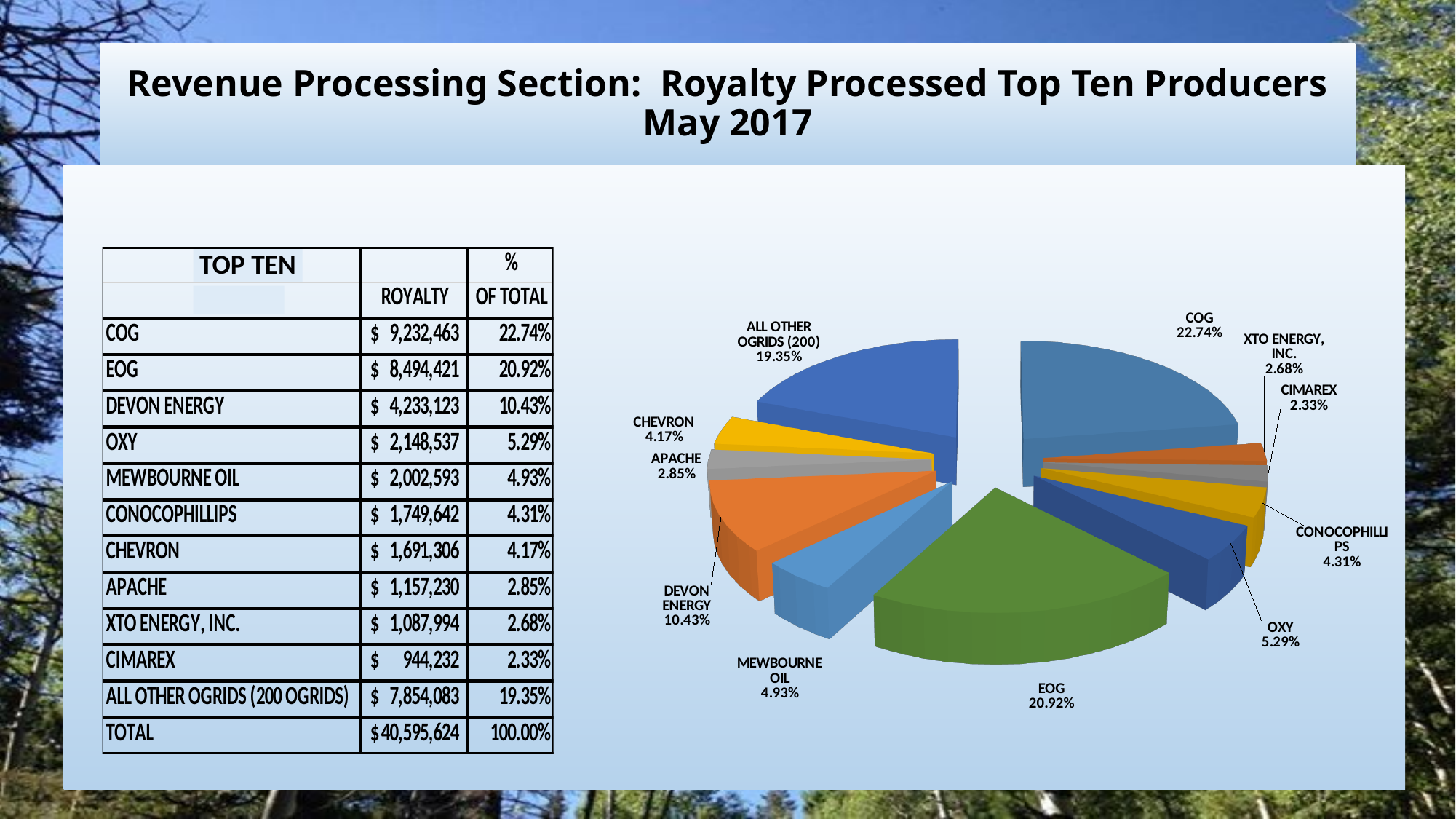
Which slice of the pie chart is the smallest? CIMAREX What colour is the EOG slice in the pie chart? green What share of the pie chart does COG account for? 22.74% What percentage is shown for ALL OTHER OGRIDS (200) in the pie chart? 19.35% What kind of chart is shown on the slide? pie chart Which slice is larger in the pie chart, DEVON ENERGY or ALL OTHER OGRIDS (200)? ALL OTHER OGRIDS (200) What share of the pie chart does EOG account for? 20.92% What is the difference in percentage points between the COG slice and the EOG slice? 1.82% How many slices does the pie chart have? 11 Which slice is larger in the pie chart, OXY or MEWBOURNE OIL? OXY Which slice of the pie chart is the largest? COG What percentage is shown for CHEVRON in the pie chart? 4.17%